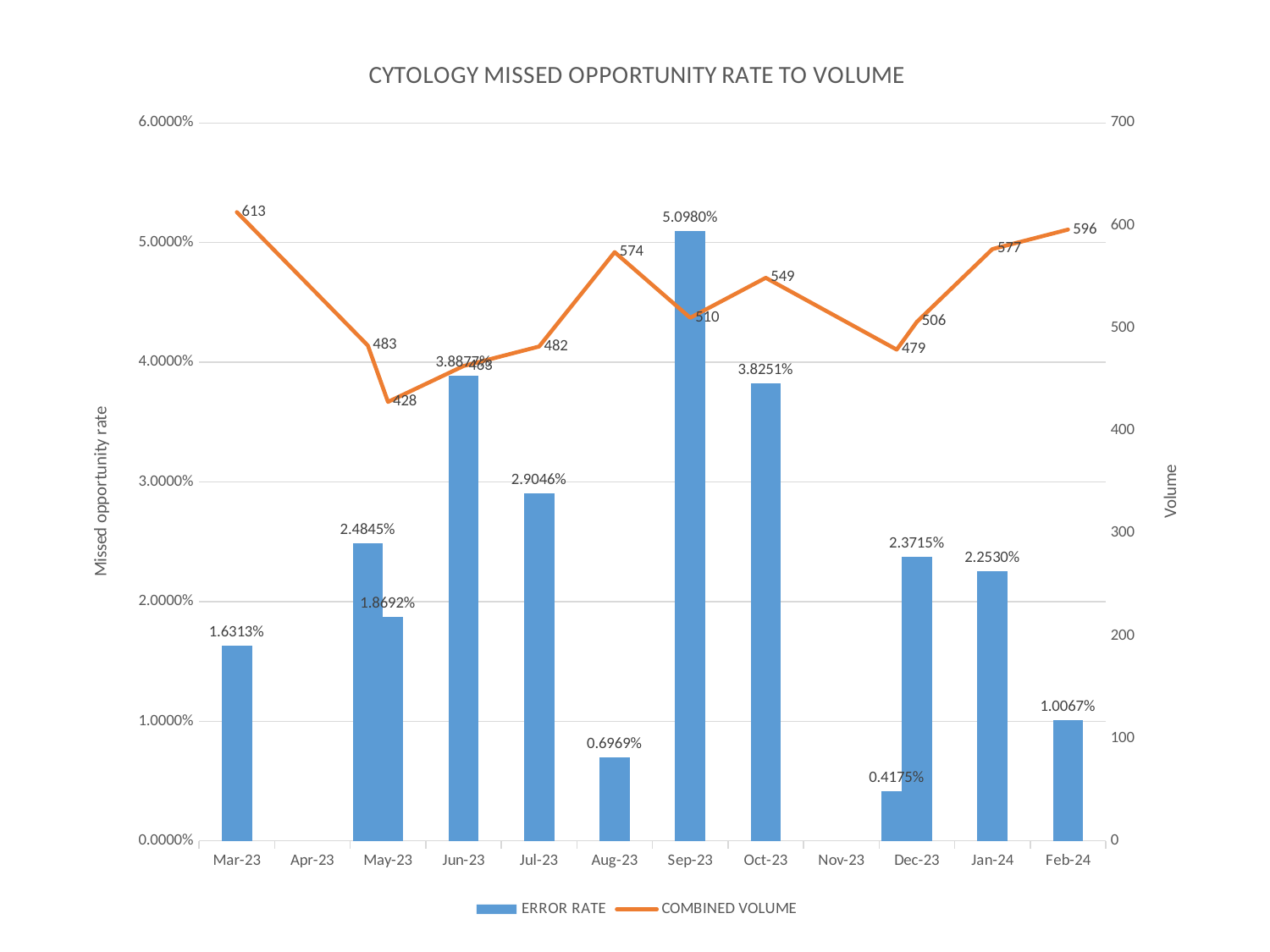
Which has the higher error rate, Jun-23 or Oct-23? Jun-23 What is the highest combined volume value shown on the line? 613 How many series does the legend list? 2 What kind of chart is this? Combination bar and line chart What is the error rate for Sep-23? 5.0980% Is the error rate for Aug-23 greater or less than 1.0000%? less What is the combined volume for Mar-23? 613 What is the title of the chart? CYTOLOGY MISSED OPPORTUNITY RATE TO VOLUME What is the difference between the error rates for Sep-23 and Oct-23? 1.2729% Which month has the highest error rate? Sep-23 What is the lowest combined volume value shown on the line? 428